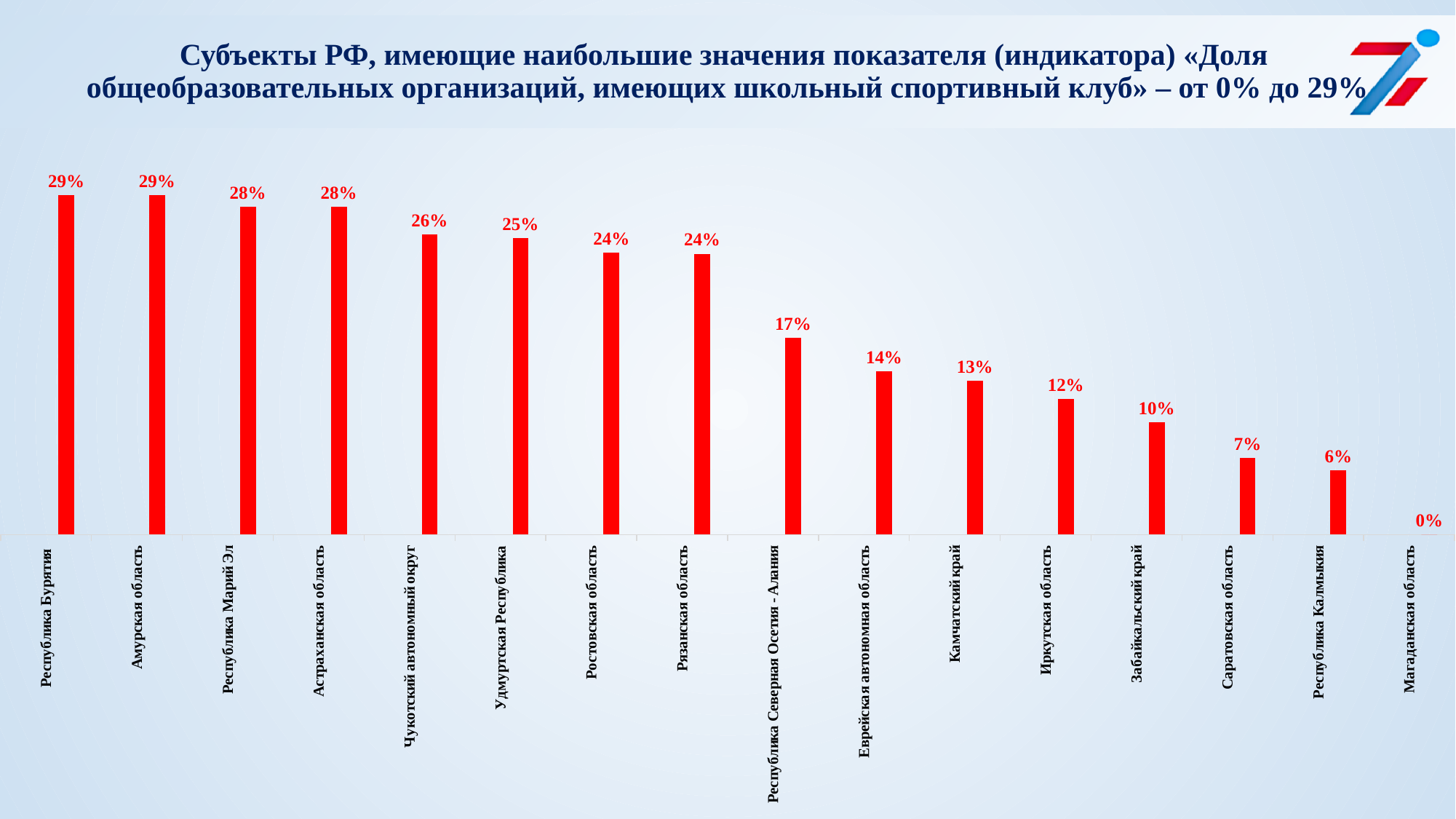
What is the value for Камчатский край? 13% What is the value for Чукотский автономный округ? 26% What is the value for Саратовская область? 7% Which is larger, the value for Рязанская область or the value for Республика Северная Осетия - Алания? Рязанская область Which category has the lowest value? Магаданская область How many categories are shown in the chart? 16 What is the value for Республика Северная Осетия - Алания? 17% What is the difference between the values for Республика Бурятия and Республика Калмыкия? 23% What is the difference between the values for Удмуртская Республика and Забайкальский край? 15% Do the values rise or fall from left to right along the x axis? Fall Which is larger, the value for Еврейская автономная область or the value for Иркутская область? Еврейская автономная область What kind of chart is shown on the slide? Bar chart